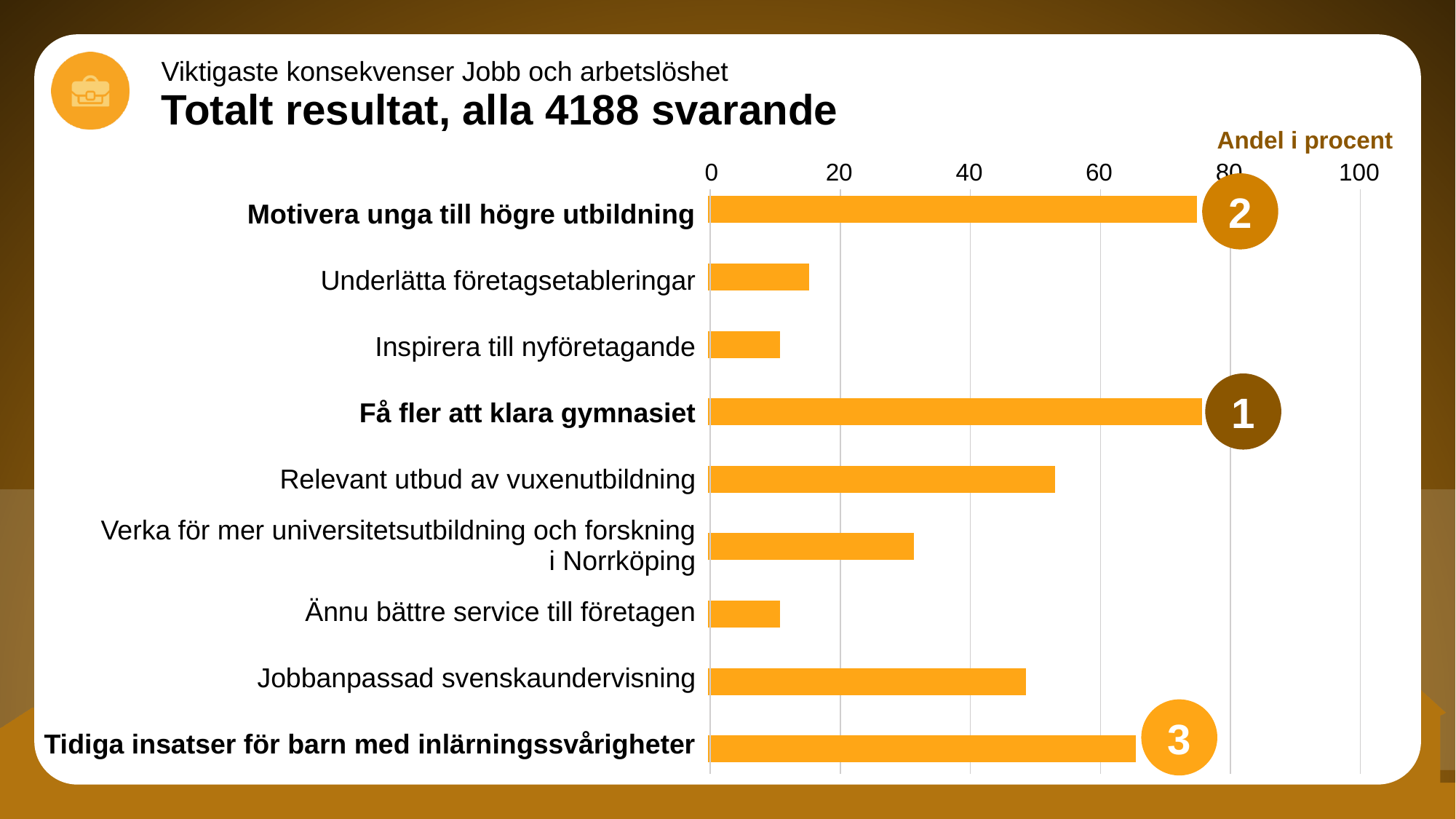
Is the value for Underlätta företagsetableringar greater or less than 20? less Is the value for Ännu bättre service till företagen greater or less than 20? less What kind of chart is shown on the slide? bar chart What label is shown above the horizontal axis of the chart? Andel i procent How many categories are plotted in the chart? 9 Which category is marked with the circled number 1? Få fler att klara gymnasiet Is the value for Tidiga insatser för barn med inlärningssvårigheter greater or less than 60? greater Which has the larger value, Verka för mer universitetsutbildning och forskning i Norrköping or Underlätta företagsetableringar? Verka för mer universitetsutbildning och forskning i Norrköping Which has the larger value, Tidiga insatser för barn med inlärningssvårigheter or Relevant utbud av vuxenutbildning? Tidiga insatser för barn med inlärningssvårigheter